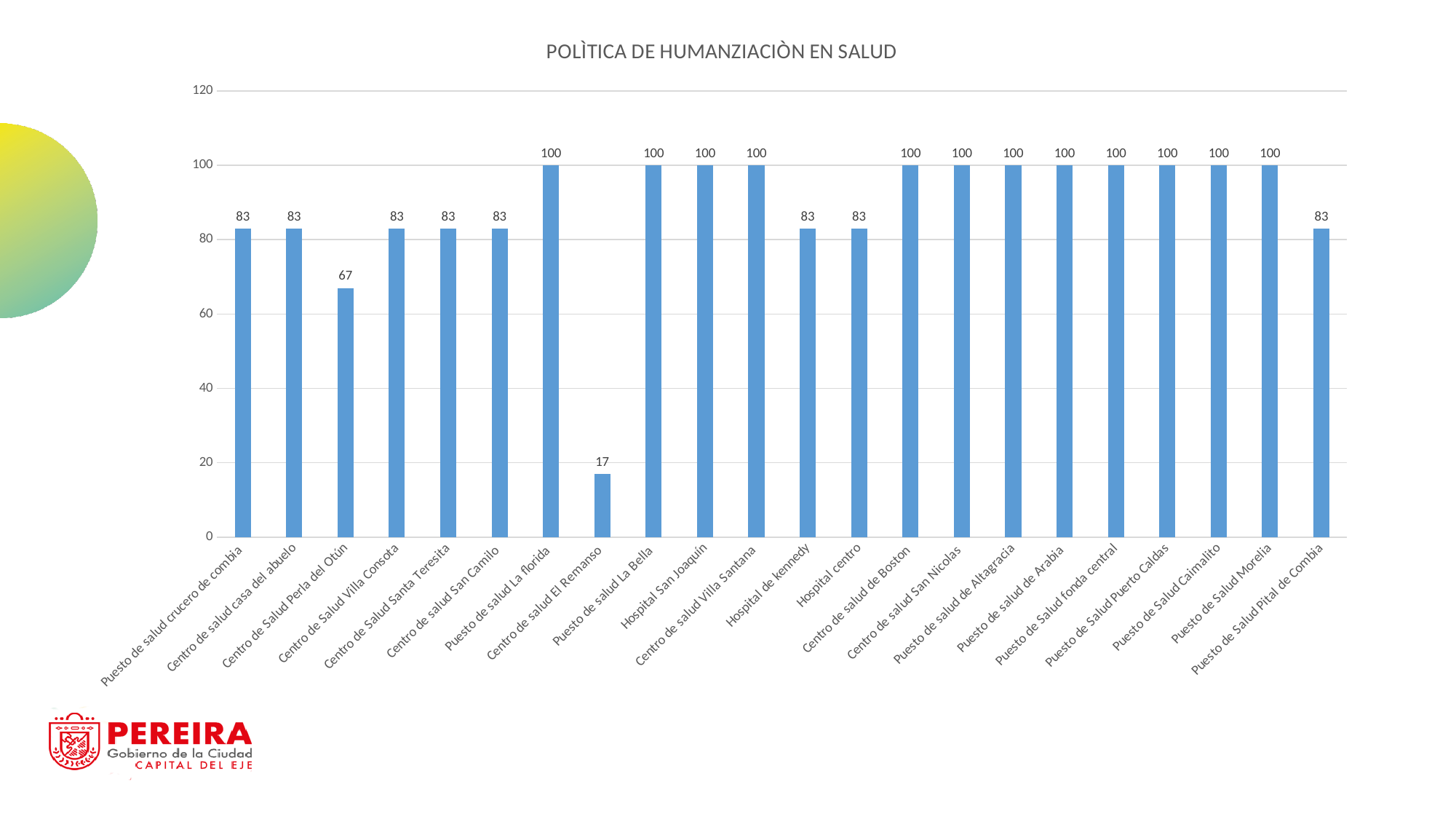
How many bars have a value of 100? 12 What is the value for Hospital San Joaquín? 100 What type of chart is shown on the slide? bar chart What is the difference between the values for Puesto de salud La florida and Centro de salud El Remanso? 83 How many categories are shown on the x axis? 22 What is the value for Centro de salud El Remanso? 17 What is the value for Puesto de Salud Pital de Combia? 83 What is the value for Centro de Salud Perla del Otún? 67 Is the value for Centro de salud El Remanso greater or less than 20? less What is the difference between the values for Hospital de kennedy and Centro de Salud Perla del Otún? 16 Which is larger, the value for Centro de salud de Boston or the value for Hospital centro? Centro de salud de Boston Which category has the lowest value? Centro de salud El Remanso